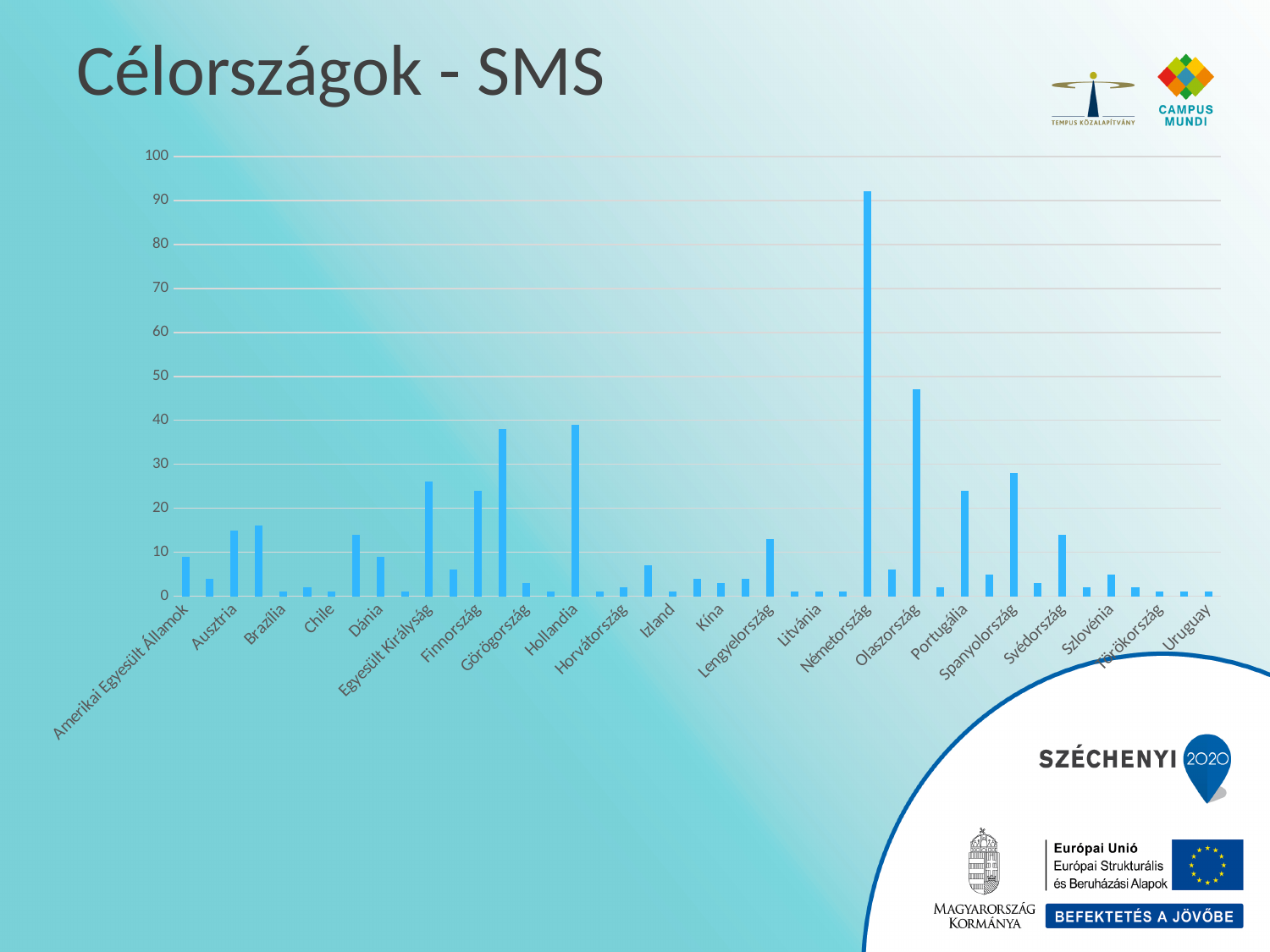
Is the value for Lengyelország greater or less than 20? less Is the value for Egyesült Királyság greater or less than 30? less Which country has the highest bar in the chart? Németország Which has the larger value, Hollandia or Egyesült Királyság? Hollandia What kind of chart is shown on the slide? bar chart Is the value for Németország greater or less than 90? greater What is the title of the chart on the slide? Célországok - SMS Which has the larger value, Ausztria or Brazília? Ausztria Which has the larger value, Olaszország or Spanyolország? Olaszország